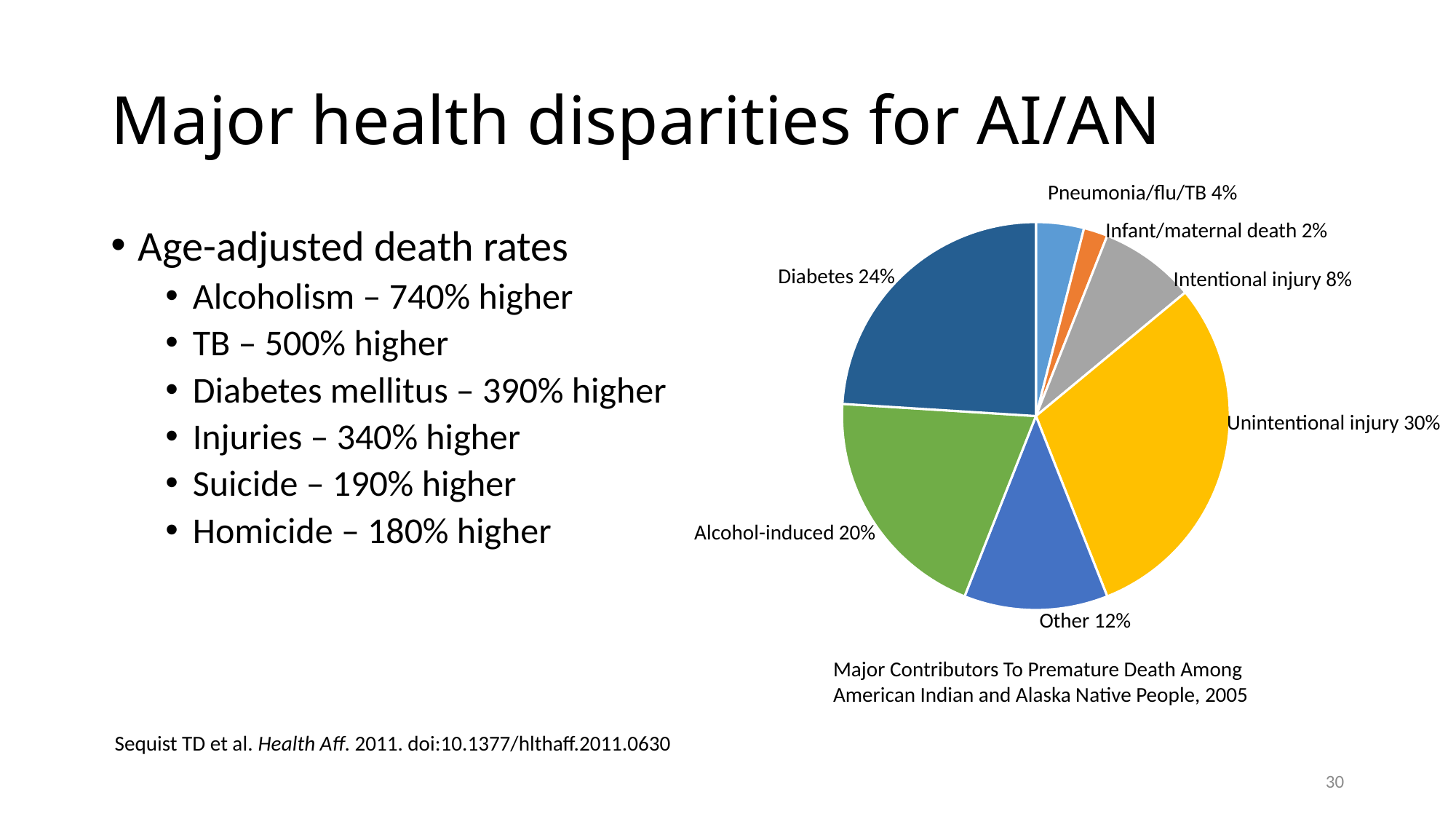
What is the difference in percentage points between Unintentional injury and Diabetes? 6 What is the title of the pie chart? Major Contributors To Premature Death Among American Indian and Alaska Native People, 2005 Which category has the smallest slice of the pie? Infant/maternal death What share of the pie does Unintentional injury represent? 30% What kind of chart is shown on the slide? Pie chart Which is larger, the slice for Alcohol-induced or the slice for Other? Alcohol-induced What share of the pie does Diabetes represent? 24% Which category has the largest slice of the pie? Unintentional injury What share of the pie does Infant/maternal death represent? 2% How many slices does the pie chart have? 7 What is the difference in percentage points between Intentional injury and Pneumonia/flu/TB? 4 What share of the pie does Alcohol-induced represent? 20%